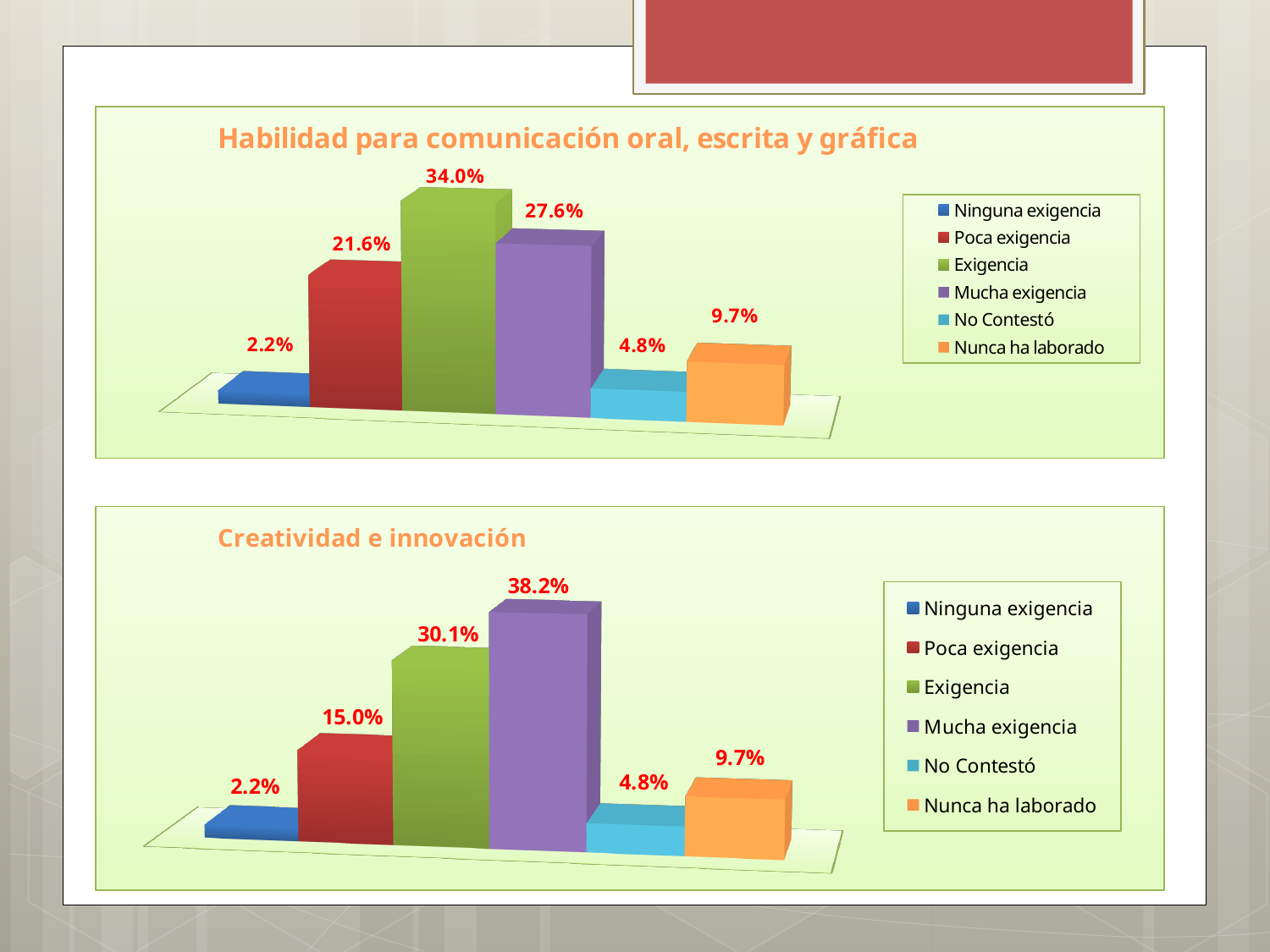
In the 'Creatividad e innovación' chart, what is the value for Mucha exigencia? 38.2% How many categories does the legend of the 'Creatividad e innovación' chart list? 6 In the 'Habilidad para comunicación oral, escrita y gráfica' chart, what is the value for Poca exigencia? 21.6% In the 'Creatividad e innovación' chart, which category has the lowest value? Ninguna exigencia In the 'Habilidad para comunicación oral, escrita y gráfica' chart, what is the value for Exigencia? 34.0% In the 'Habilidad para comunicación oral, escrita y gráfica' chart, what is the difference between Exigencia and Mucha exigencia? 6.4% In the 'Creatividad e innovación' chart, what is the value for Poca exigencia? 15.0% In the 'Habilidad para comunicación oral, escrita y gráfica' chart, which category has the highest value? Exigencia In the 'Creatividad e innovación' chart, what is the difference between Mucha exigencia and Exigencia? 8.1% In the 'Habilidad para comunicación oral, escrita y gráfica' chart, what colour is the Mucha exigencia bar? Purple What kind of chart is the 'Habilidad para comunicación oral, escrita y gráfica' chart? Bar chart In the 'Creatividad e innovación' chart, which is larger: Nunca ha laborado or No Contestó? Nunca ha laborado